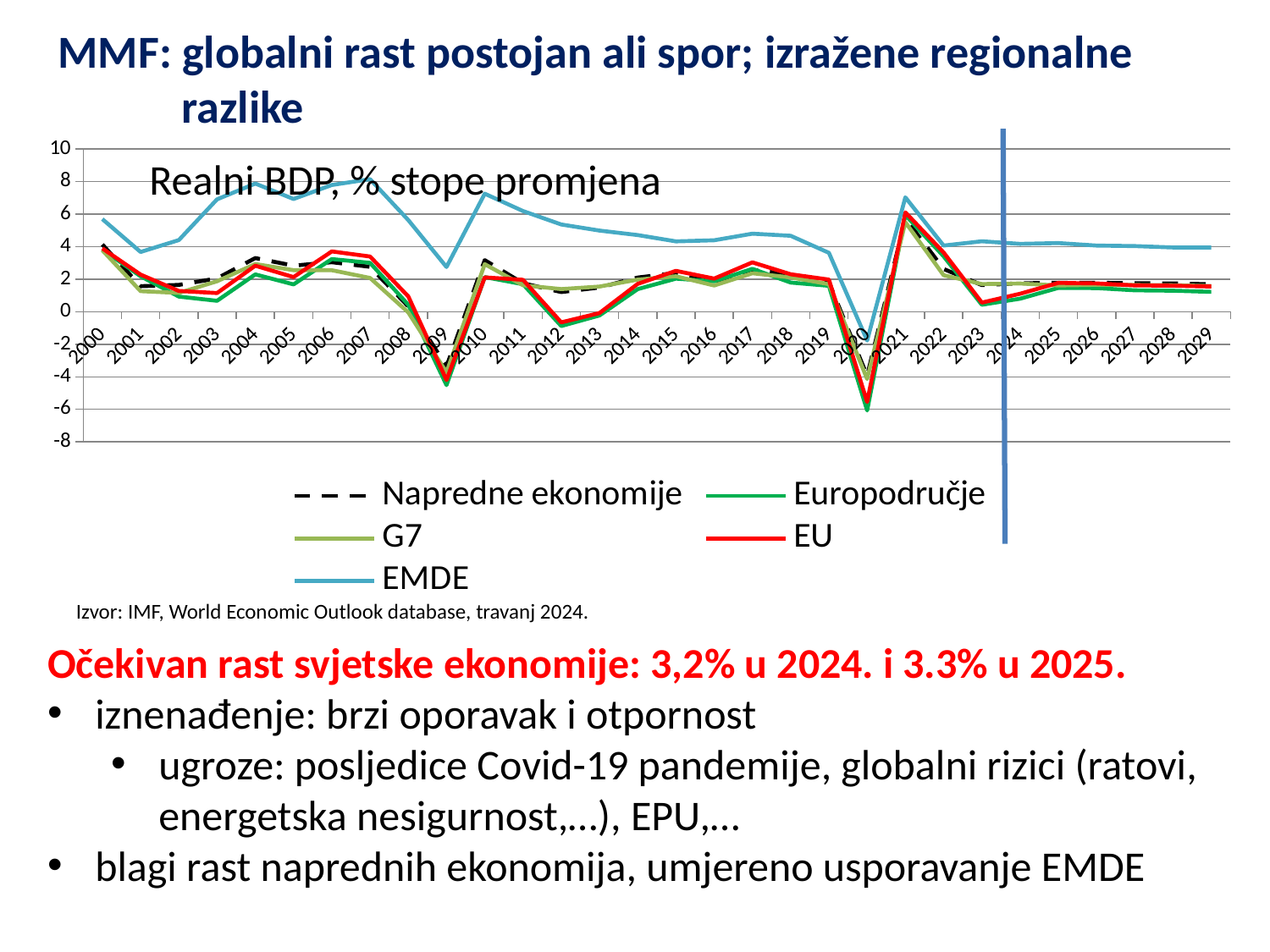
In 2020, which is larger: the value for EMDE or the value for Europodručje? EMDE What is the title printed inside the chart area? Realni BDP, % stope promjena What kind of chart is shown on the slide? line chart Which series has the highest value in 2007? EMDE Does the EMDE series rise or fall from 2007 to 2009? fall How many years are shown on the x axis of the chart? 30 Is the value for EU in 2021 greater or less than 4? greater Is the value for EMDE in 2007 greater or less than 6? greater In which year does the Europodručje series reach its lowest value? 2020 Is the value for Europodručje in 2009 greater or less than -2? less How many series does the chart legend list? 5 Which series in the legend is drawn with a dashed line? Napredne ekonomije